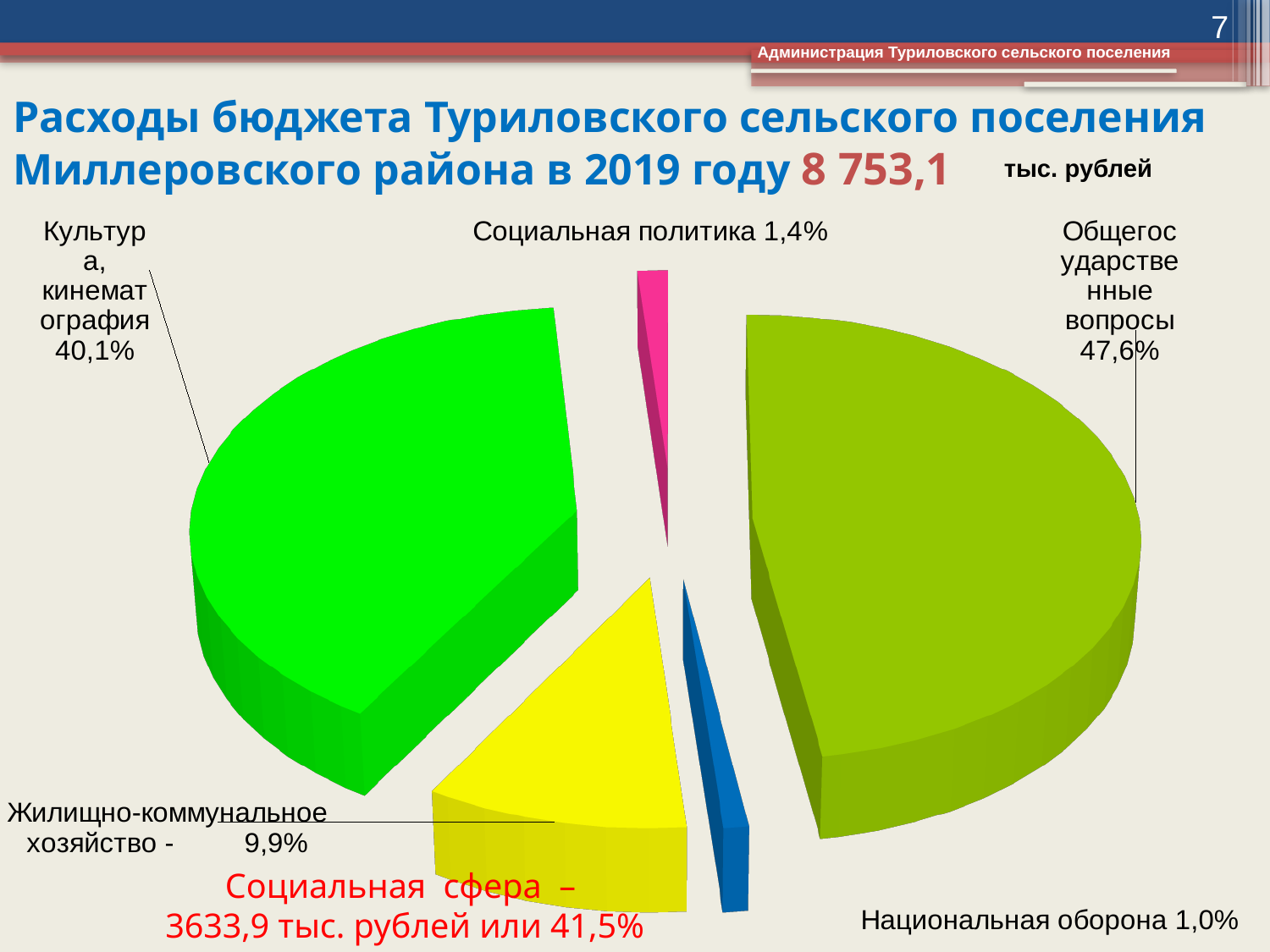
What is the difference in percentage points between Общегосударственные вопросы and Культура, кинематография? 7,5 What kind of chart is shown on the slide? Pie chart How many slices does the pie chart have? 5 What share of the budget expenditure goes to Социальная политика? 1,4% What share of the budget expenditure goes to Жилищно-коммунальное хозяйство? 9,9% What share of the budget expenditure goes to Национальная оборона? 1,0% Which category has the smallest share of the pie? Национальная оборона What total budget expenditure amount (in тыс. рублей) is stated in the slide title? 8 753,1 What share of the budget expenditure goes to Общегосударственные вопросы? 47,6% What share of the budget expenditure goes to Культура, кинематография? 40,1% Which is larger: the share for Жилищно-коммунальное хозяйство or the share for Социальная политика? Жилищно-коммунальное хозяйство Which category has the largest share of the pie? Общегосударственные вопросы